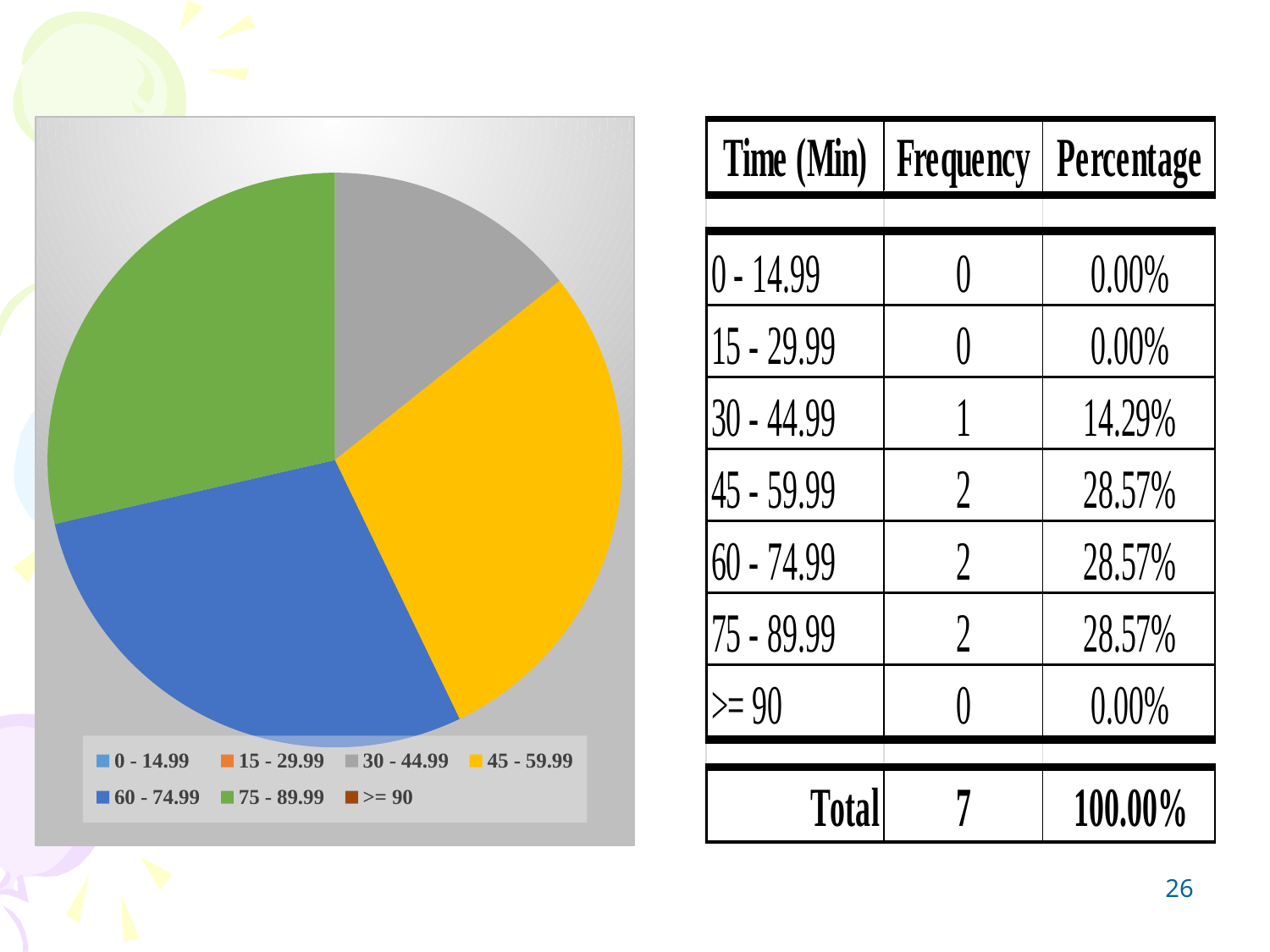
According to the table, what is the frequency for the 75 - 89.99 category? 2 How many entries does the pie chart's legend list? 7 Which of the visible slices in the pie chart is the smallest? 30 - 44.99 According to the table, what is the total frequency across all categories? 7 According to the table, what percentage corresponds to the 30 - 44.99 slice of the pie chart? 14.29% What colour is the 45 - 59.99 slice in the pie chart? yellow Which slice is larger in the pie chart: 60 - 74.99 or 30 - 44.99? 60 - 74.99 What kind of chart is shown on the left of the slide? pie chart How many legend categories have a frequency of 0 according to the table? 3 What is the difference in percentage between the 45 - 59.99 and 30 - 44.99 categories, as shown in the table? 14.28% According to the table, what percentage corresponds to the 45 - 59.99 slice of the pie chart? 28.57% Which slice is larger in the pie chart: 30 - 44.99 or 45 - 59.99? 45 - 59.99